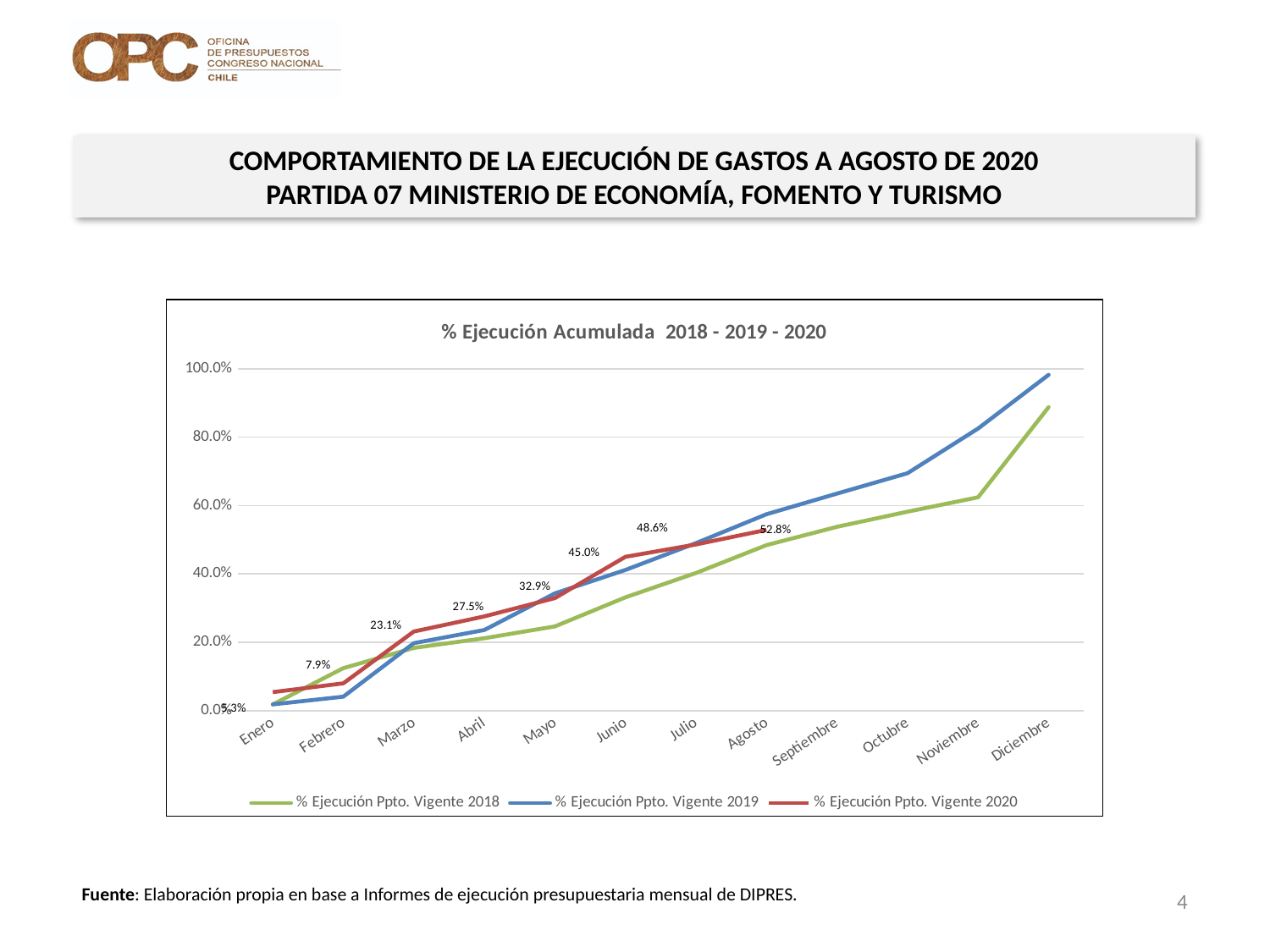
What is the difference between the 2020 values for Junio and Mayo? 12.1% Does the % Ejecución Ppto. Vigente 2020 line rise or fall from Enero to Agosto? Rise By how many percentage points did % Ejecución Ppto. Vigente 2020 increase from Julio to Agosto? 4.2% Is the value for % Ejecución Ppto. Vigente 2019 in Diciembre greater or less than 80.0%? greater How many series does the legend list? 3 What is the value of % Ejecución Ppto. Vigente 2020 in Marzo? 23.1% What kind of chart is shown on the slide? Line chart In Diciembre, which series is higher: % Ejecución Ppto. Vigente 2018 or % Ejecución Ppto. Vigente 2019? % Ejecución Ppto. Vigente 2019 How many months are shown along the x axis? 12 What is the value of % Ejecución Ppto. Vigente 2020 in Agosto? 52.8% What is the title of the chart? % Ejecución Acumulada 2018 - 2019 - 2020 What is the value of % Ejecución Ppto. Vigente 2020 in Junio? 45.0%